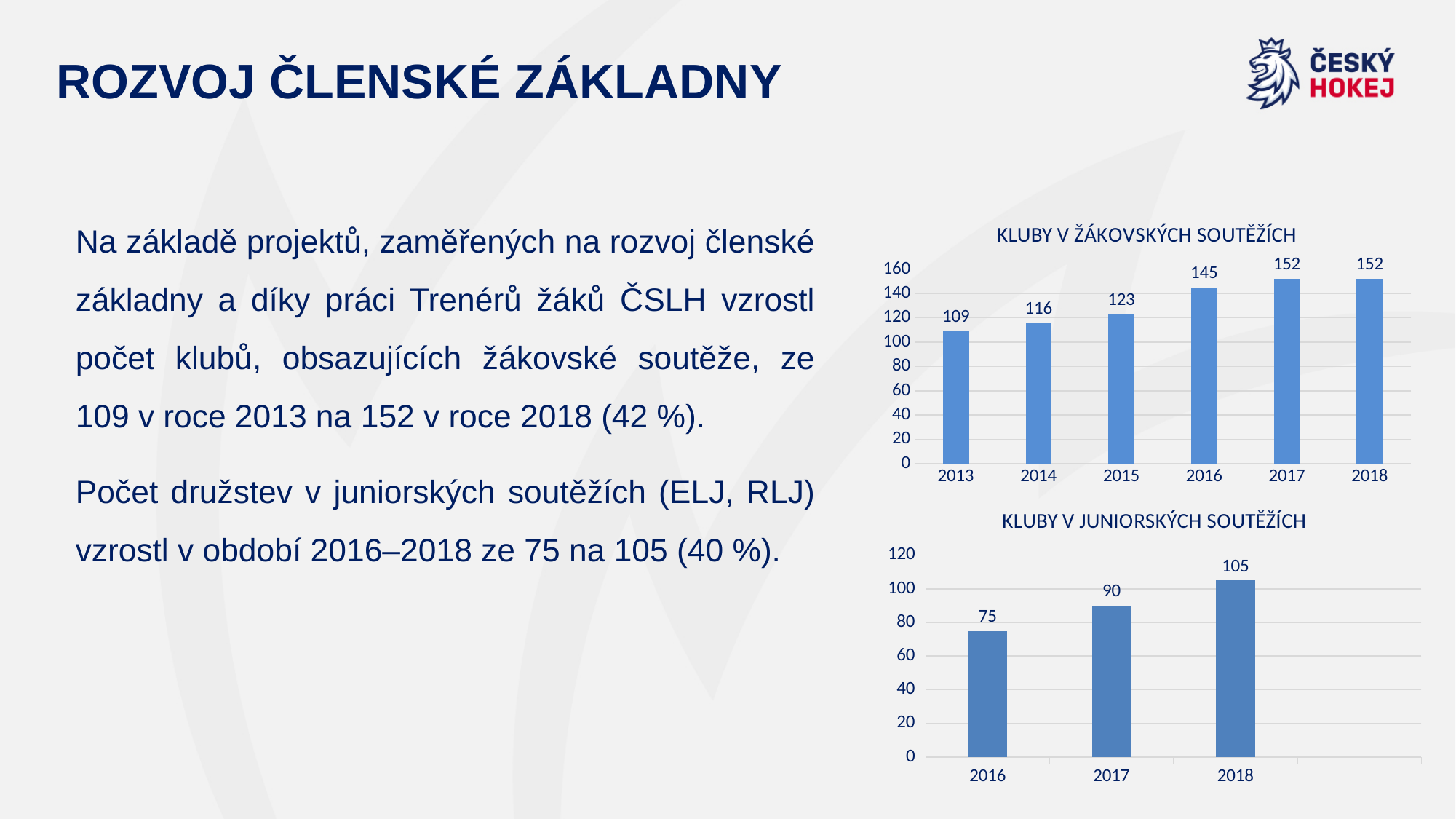
In the chart titled 'KLUBY V JUNIORSKÝCH SOUTĚŽÍCH', what is the value for 2017? 90 In the chart titled 'KLUBY V ŽÁKOVSKÝCH SOUTĚŽÍCH', what is the difference between the values for 2018 and 2013? 43 What type of chart is the chart titled 'KLUBY V JUNIORSKÝCH SOUTĚŽÍCH'? bar chart In the chart titled 'KLUBY V ŽÁKOVSKÝCH SOUTĚŽÍCH', what is the value for 2015? 123 In the chart titled 'KLUBY V ŽÁKOVSKÝCH SOUTĚŽÍCH', which year has the lowest value? 2013 In the chart titled 'KLUBY V JUNIORSKÝCH SOUTĚŽÍCH', which year has the highest value? 2018 In the chart titled 'KLUBY V JUNIORSKÝCH SOUTĚŽÍCH', how many bars are there? 3 In the chart titled 'KLUBY V JUNIORSKÝCH SOUTĚŽÍCH', what is the difference between the values for 2018 and 2016? 30 In the chart titled 'KLUBY V ŽÁKOVSKÝCH SOUTĚŽÍCH', how many years are shown on the x axis? 6 In the chart titled 'KLUBY V ŽÁKOVSKÝCH SOUTĚŽÍCH', do the values rise or fall from 2013 to 2018? rise What is the title of the upper chart on the slide? KLUBY V ŽÁKOVSKÝCH SOUTĚŽÍCH In the chart titled 'KLUBY V ŽÁKOVSKÝCH SOUTĚŽÍCH', which is larger, the value for 2014 or the value for 2016? 2016